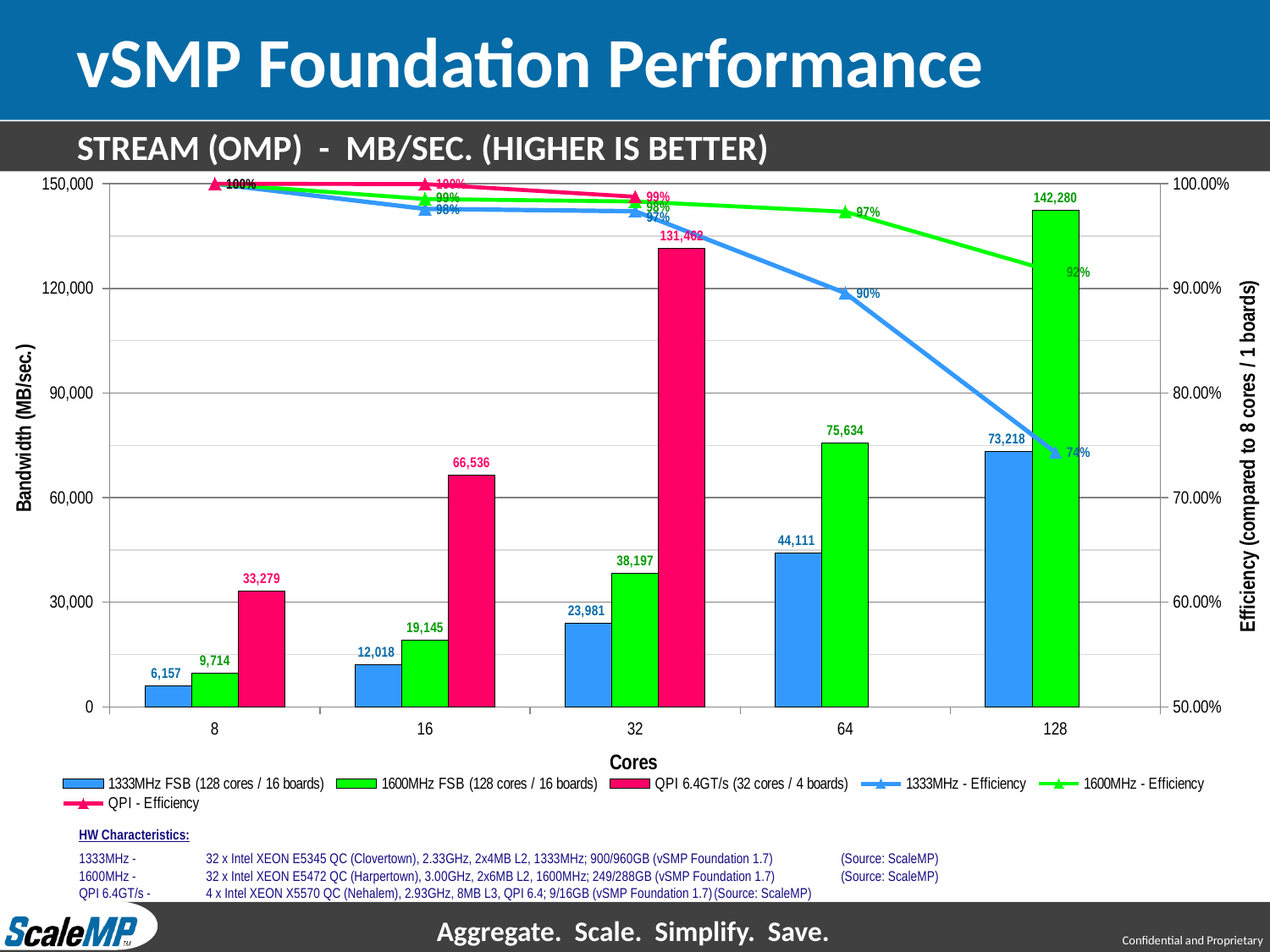
Which bar has the highest bandwidth value on the chart? 1600MHz FSB at 128 cores (142,280) What is the bandwidth for the 1600MHz FSB series at 128 cores? 142,280 How many core counts are shown on the x axis? 5 At 32 cores, which has the larger bandwidth: 1600MHz FSB or 1333MHz FSB? 1600MHz FSB Does the 1333MHz efficiency line rise or fall as the number of cores increases? Falls What is the 1600MHz efficiency value at 64 cores? 97% How many series does the legend list? 6 What is the bandwidth for the QPI 6.4GT/s series at 16 cores? 66,536 What is the difference in bandwidth between the 1600MHz FSB and 1333MHz FSB series at 128 cores? 69,062 What is the 1333MHz efficiency value at 128 cores? 74% Which bar has the lowest bandwidth value on the chart? 1333MHz FSB at 8 cores (6,157) What is the bandwidth for the 1333MHz FSB series at 64 cores? 44,111